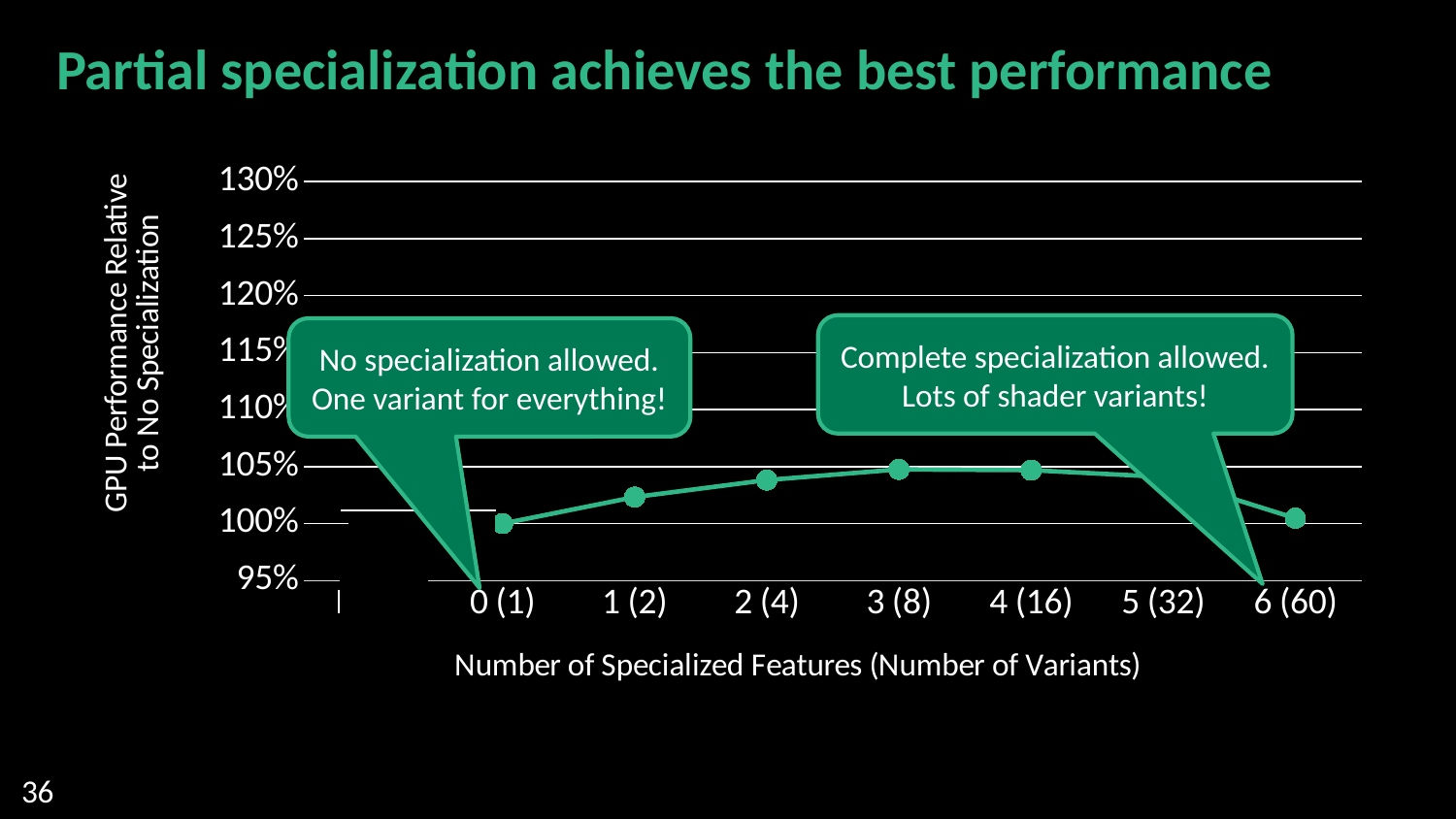
Is the value for 2 (4) greater or less than 100%? greater What is the label of the x axis? Number of Specialized Features (Number of Variants) What kind of chart is shown on the slide? line chart Which has the higher GPU performance, 0 (1) or 2 (4)? 2 (4) Is the value for 6 (60) greater or less than 105%? less Does the GPU performance rise or fall from 0 (1) to 3 (8)? rise Is the value for 3 (8) greater or less than 100%? greater Which has the higher GPU performance, 3 (8) or 6 (60)? 3 (8) What is the title of the slide's chart? Partial specialization achieves the best performance Does the GPU performance rise or fall from 4 (16) to 6 (60)? fall How many categories are shown on the x axis of the chart? 7